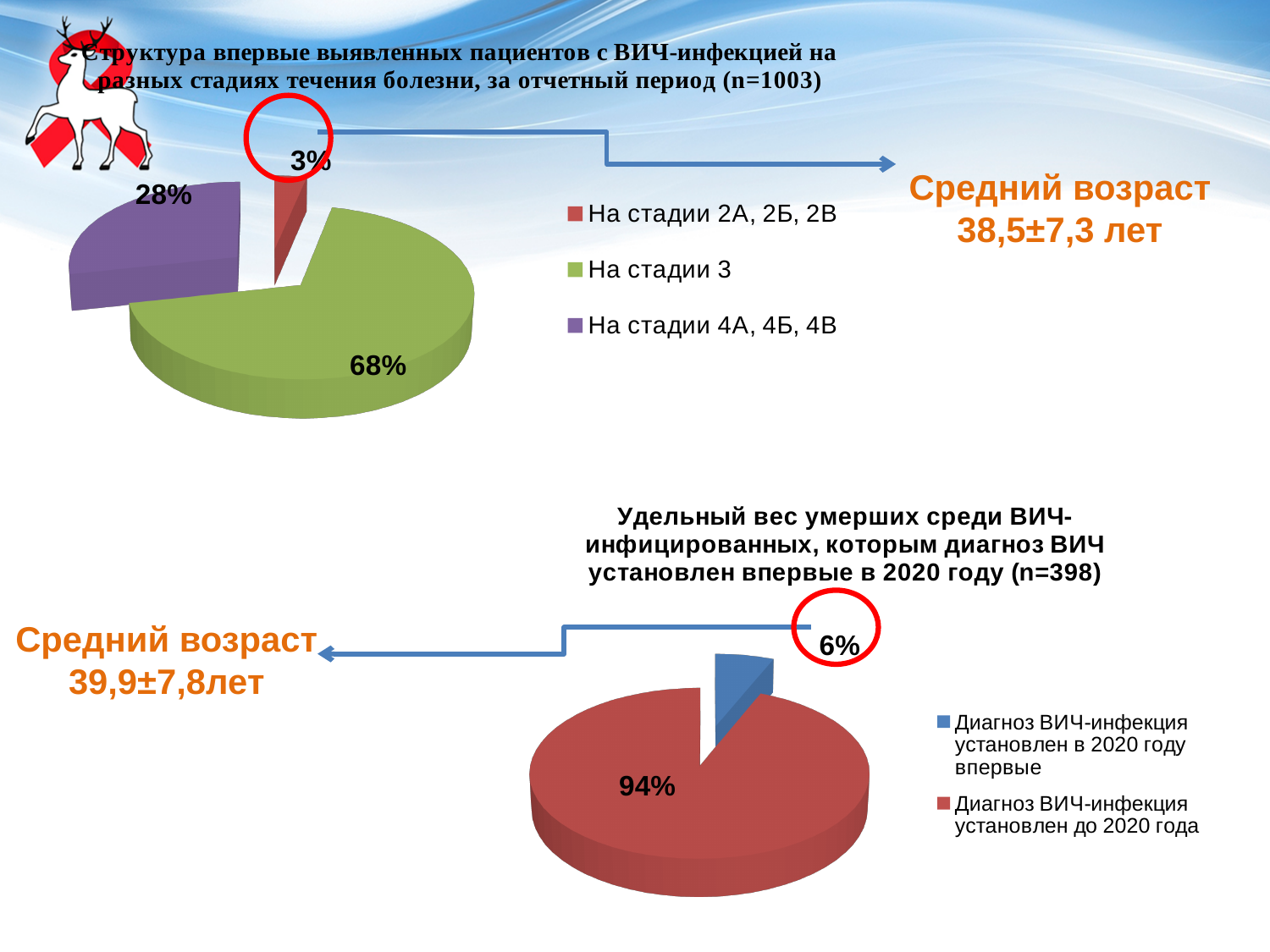
In the bottom chart (Удельный вес умерших среди ВИЧ-инфицированных...), which category is larger: 'Диагноз ВИЧ-инфекция установлен в 2020 году впервые' or 'Диагноз ВИЧ-инфекция установлен до 2020 года'? Диагноз ВИЧ-инфекция установлен до 2020 года In the bottom chart (Удельный вес умерших среди ВИЧ-инфицированных...), what share is shown for 'Диагноз ВИЧ-инфекция установлен до 2020 года'? 94% In the bottom chart (Удельный вес умерших среди ВИЧ-инфицированных...), what share is shown for 'Диагноз ВИЧ-инфекция установлен в 2020 году впервые'? 6% In the top chart (Структура впервые выявленных пациентов с ВИЧ-инфекцией...), what share is shown for 'На стадии 4А, 4Б, 4В'? 28% In the top chart (Структура впервые выявленных пациентов с ВИЧ-инфекцией...), what is the difference in percentage points between 'На стадии 3' and 'На стадии 4А, 4Б, 4В'? 40 In the bottom chart (Удельный вес умерших среди ВИЧ-инфицированных...), what colour is the slice for 'Диагноз ВИЧ-инфекция установлен в 2020 году впервые'? Blue In the top chart (Структура впервые выявленных пациентов с ВИЧ-инфекцией...), which category has the smallest slice? На стадии 2А, 2Б, 2В What type of chart is the top chart (Структура впервые выявленных пациентов с ВИЧ-инфекцией...)? Pie chart How many categories does the legend of the top chart (Структура впервые выявленных пациентов с ВИЧ-инфекцией...) list? 3 In the top chart (Структура впервые выявленных пациентов с ВИЧ-инфекцией...), which category has the largest slice? На стадии 3